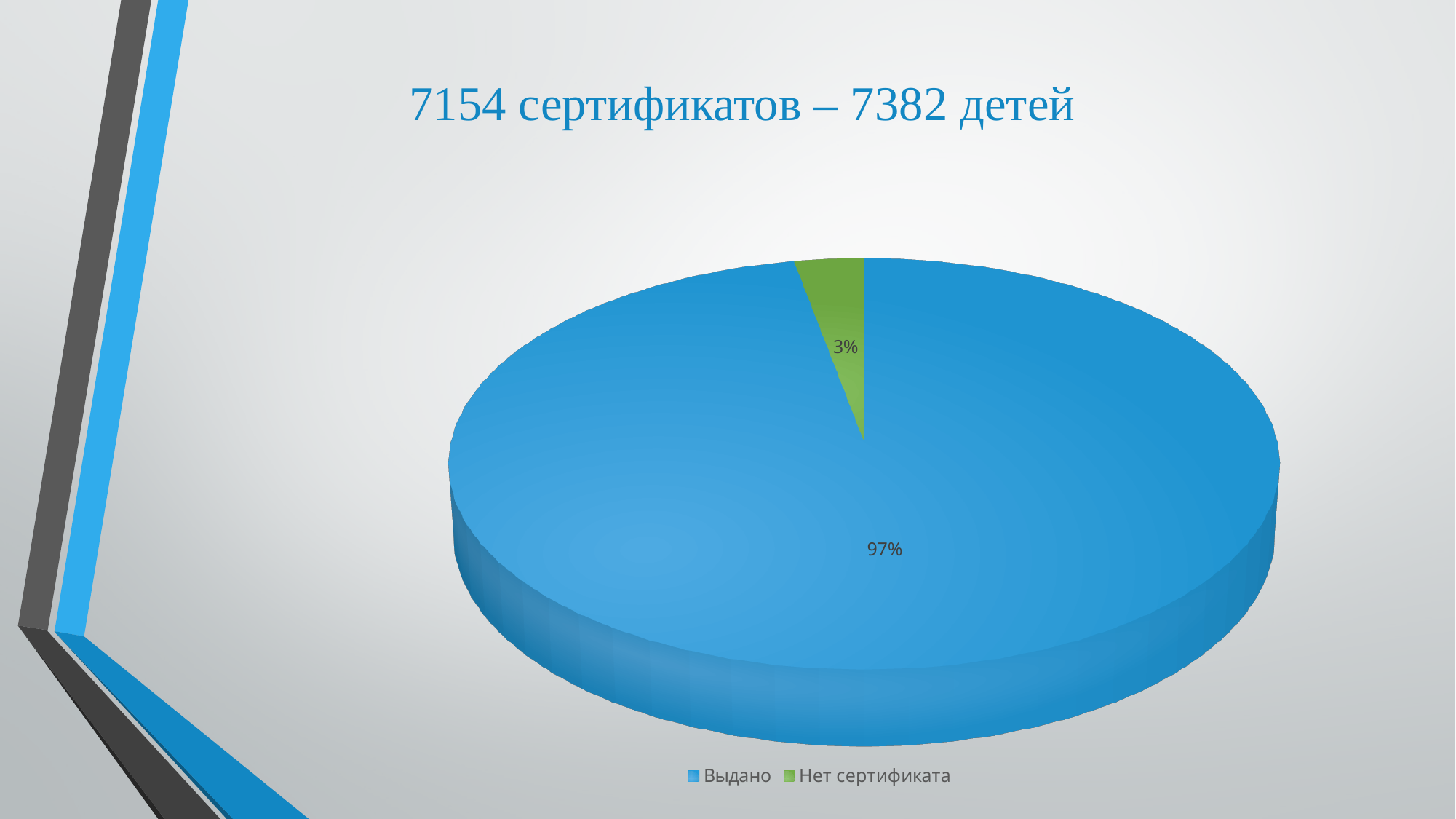
Which slice of the pie is the smallest? Нет сертификата What colour is the "Нет сертификата" slice? green What kind of chart is shown on the slide? pie chart What share of the pie does the "Нет сертификата" slice represent? 3% How many slices does the pie chart have? 2 What is the difference in percentage points between the "Выдано" and "Нет сертификата" slices? 94 What share of the pie does the "Выдано" slice represent? 97% Which is larger, the "Выдано" slice or the "Нет сертификата" slice? Выдано How many entries does the legend list? 2 Which slice of the pie is the largest? Выдано What is the title shown above the chart? 7154 сертификатов – 7382 детей